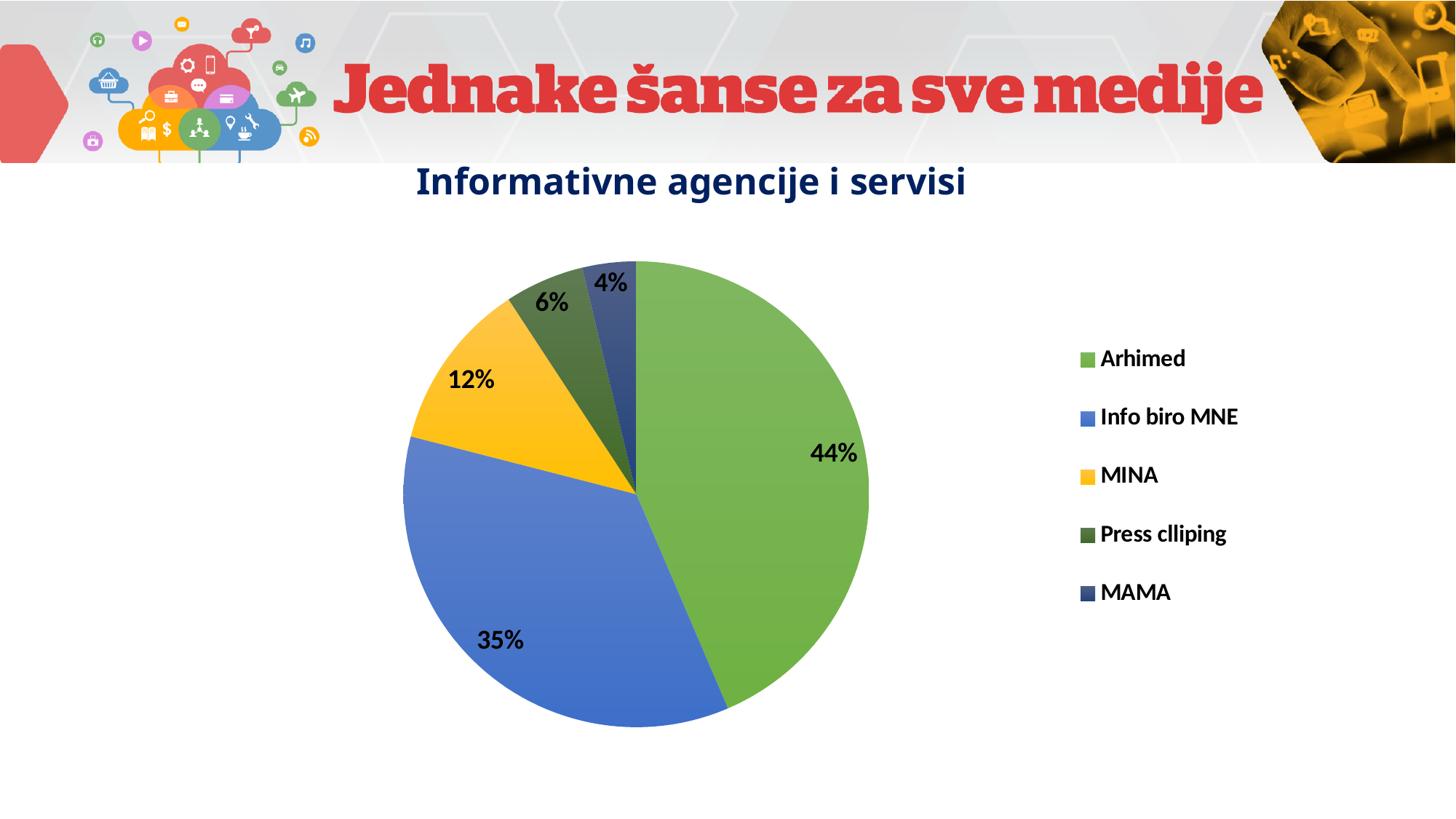
Which is larger, the share for MINA or the share for Press clliping? MINA What kind of chart is shown on the slide? pie chart What is the difference between the shares of Arhimed and Info biro MNE? 9% What is the value for Press clliping? 6% Which category has the smallest slice? MAMA Which category has the largest slice? Arhimed What is the value for MINA? 12% What share of the pie does Arhimed have? 44% What is the title of the chart? Informativne agencije i servisi What share of the pie does Info biro MNE have? 35% What is the value for MAMA? 4% How many categories does the pie chart have? 5